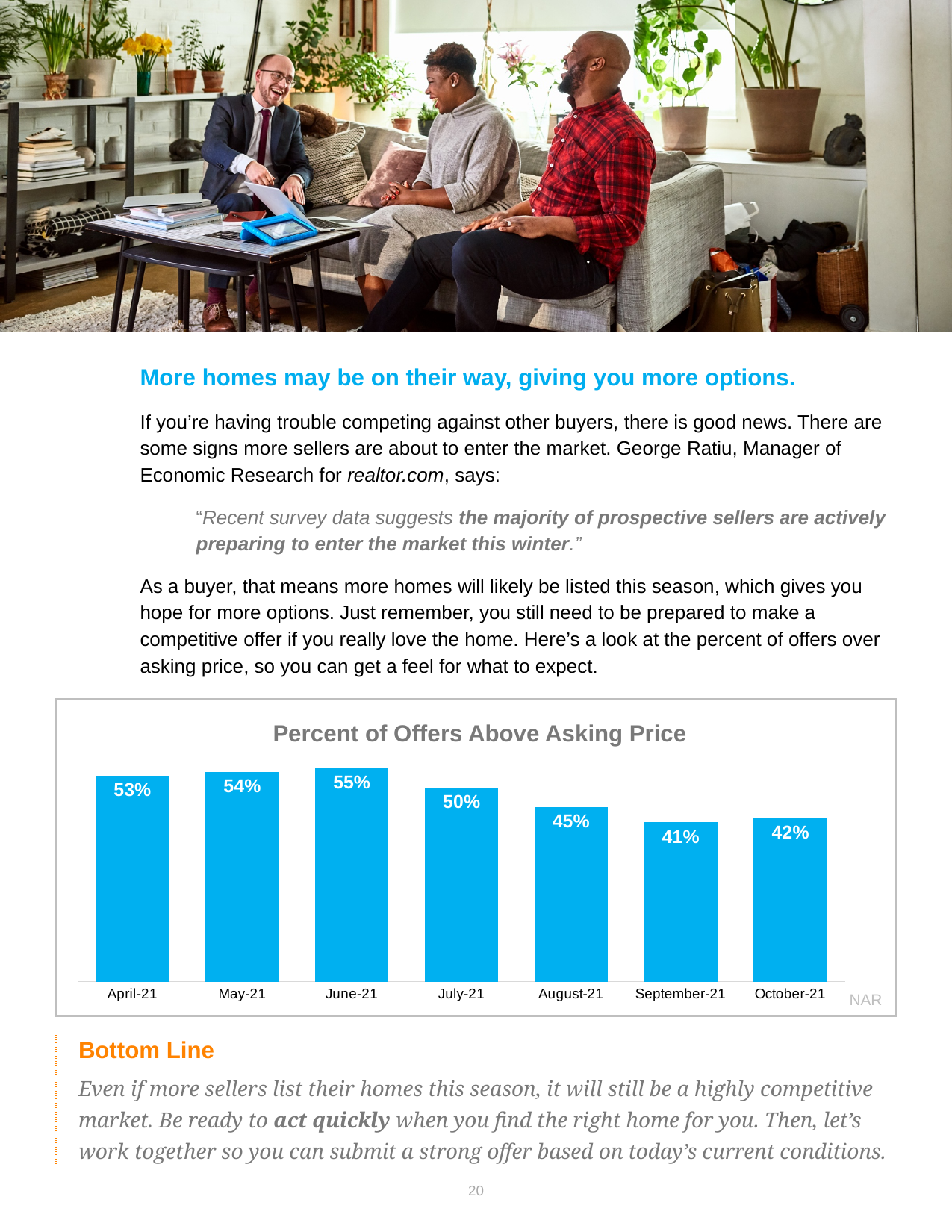
What is the value shown for April-21? 53% Which month has the lowest percent of offers above asking price? September-21 Which is larger, the value for May-21 or the value for October-21? May-21 Do the values generally rise or fall from April-21 to September-21? Fall What is the percent of offers above asking price for September-21? 41% What kind of chart is shown on the slide? Bar chart What is the difference between the values for July-21 and August-21? 5% What is the difference between the values for June-21 and September-21? 14% What is the percent of offers above asking price for June-21? 55% What is the title of the chart? Percent of Offers Above Asking Price Which month has the highest percent of offers above asking price? June-21 How many months are shown in the chart? 7